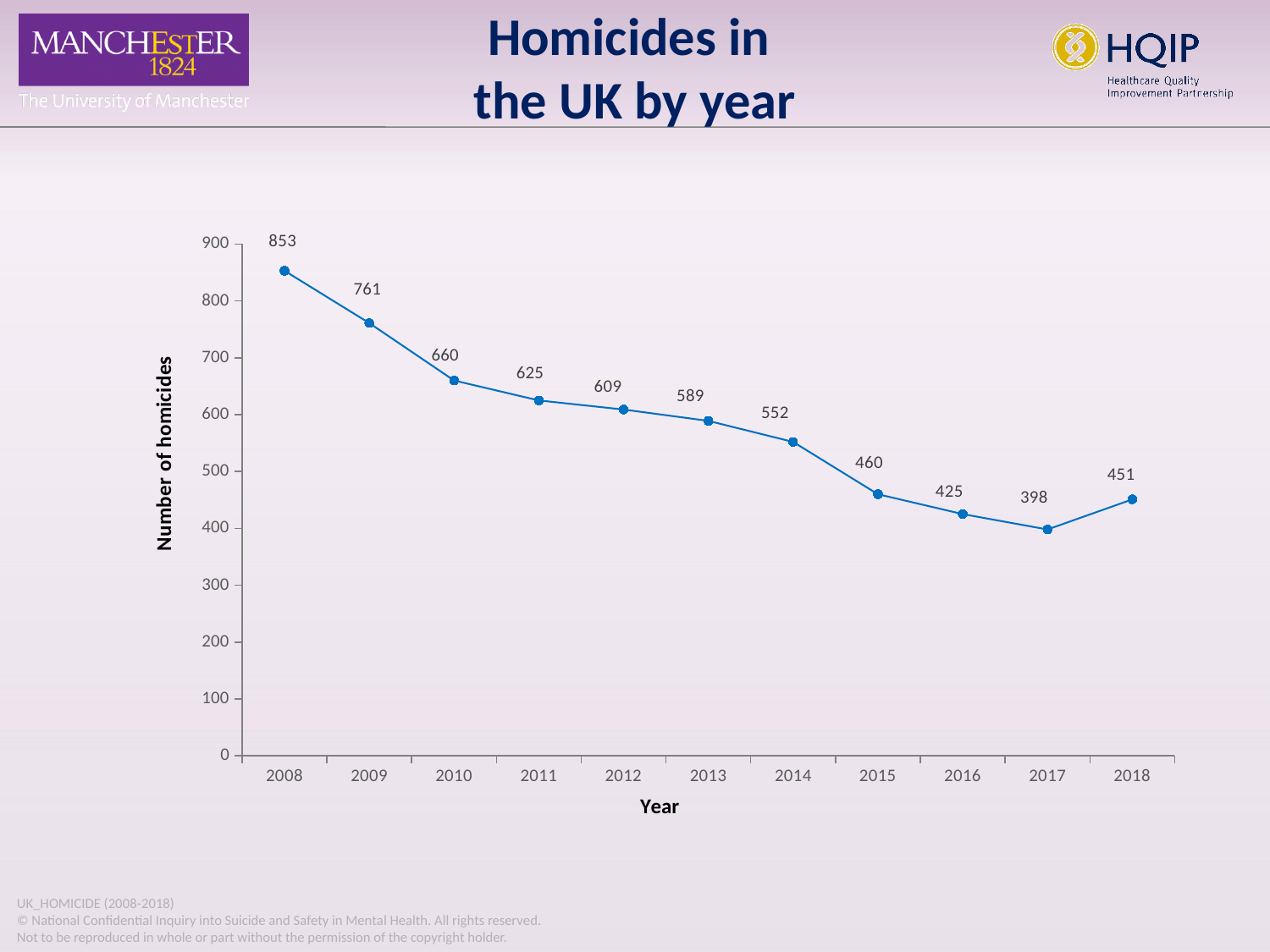
Which year has the highest number of homicides? 2008 What is the number of homicides in the UK in 2017? 398 Which year has the lowest number of homicides? 2017 How many years are plotted on the chart? 11 What is the number of homicides in the UK in 2008? 853 What is the overall trend in the number of homicides from 2008 to 2017? Falling Is the number of homicides in 2010 greater or less than 700? less What is the difference in the number of homicides between 2014 and 2015? 92 What kind of chart is shown on the slide? Line chart What is the number of homicides in the UK in 2013? 589 What is the difference in the number of homicides between 2008 and 2018? 402 Which year has more homicides, 2016 or 2018? 2018